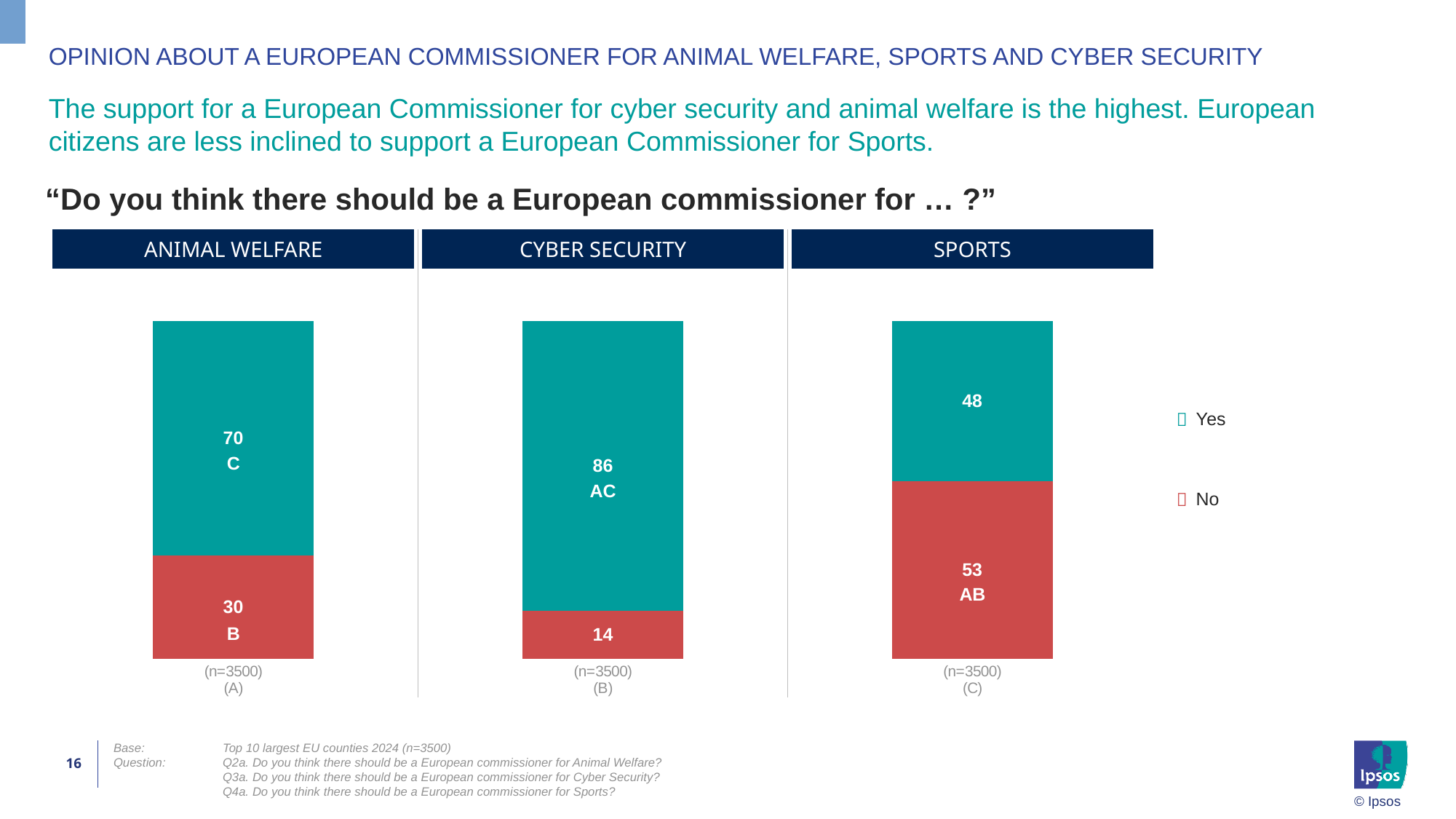
What is the difference between the Yes value in the Cyber Security chart and the Yes value in the Animal Welfare chart? 16 Across the three charts, which topic has the lowest Yes value? Sports What kind of chart is used to show the Yes and No responses? Stacked bar chart In the Sports chart, what is the value for No? 53 Which colour represents the No responses in the charts? Red In the Sports chart, what is the value for Yes? 48 In the Sports chart, which is larger, the Yes value or the No value? No In the Cyber Security chart, what is the value for No? 14 In the Animal Welfare chart, what percentage of respondents answered Yes? 70 In the Animal Welfare chart, what is the difference between the Yes and No values? 40 How many series does the legend list? 2 Across the three charts (Animal Welfare, Cyber Security, Sports), which topic has the highest Yes value? Cyber Security